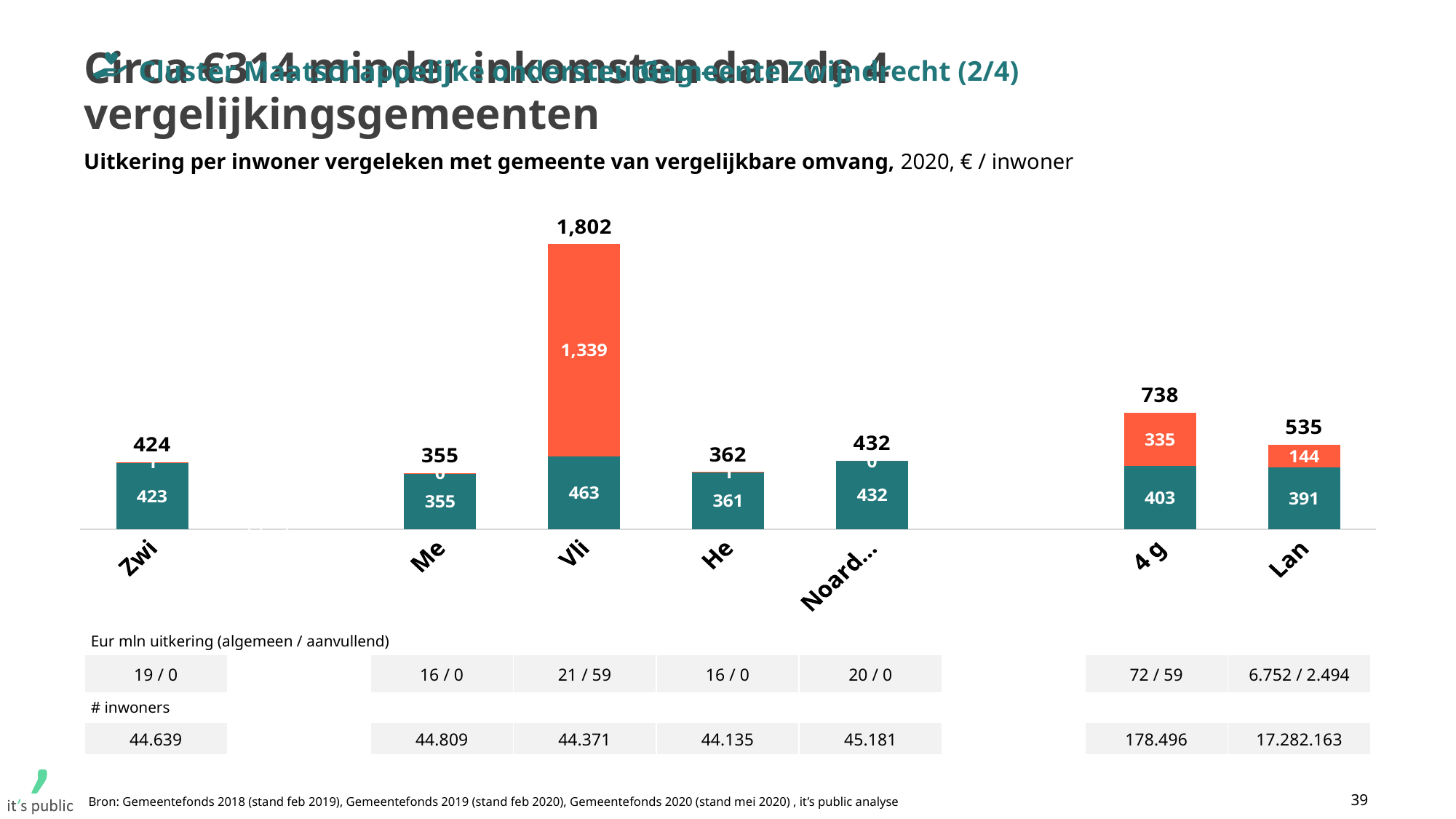
In what unit are the chart values expressed, according to the subtitle? € / inwoner What is the difference between the total for Vli and the total for 4 g? 1,064 What kind of chart is shown on the slide? Stacked bar chart How many categories are plotted on the chart? 7 What is the value of the orange (top) segment for Lan? 144 What is the value of the teal (bottom) segment for 4 g? 403 What is the difference between the total for Lan and the total for Zwi? 111 Which has a larger total, Zwi or Noard...? Noard... Which category has the lowest total bar value? Me What is the total value shown above the bar for Vli? 1,802 What is the value of the orange (top) segment for Vli? 1,339 Which category has the highest total bar value? Vli